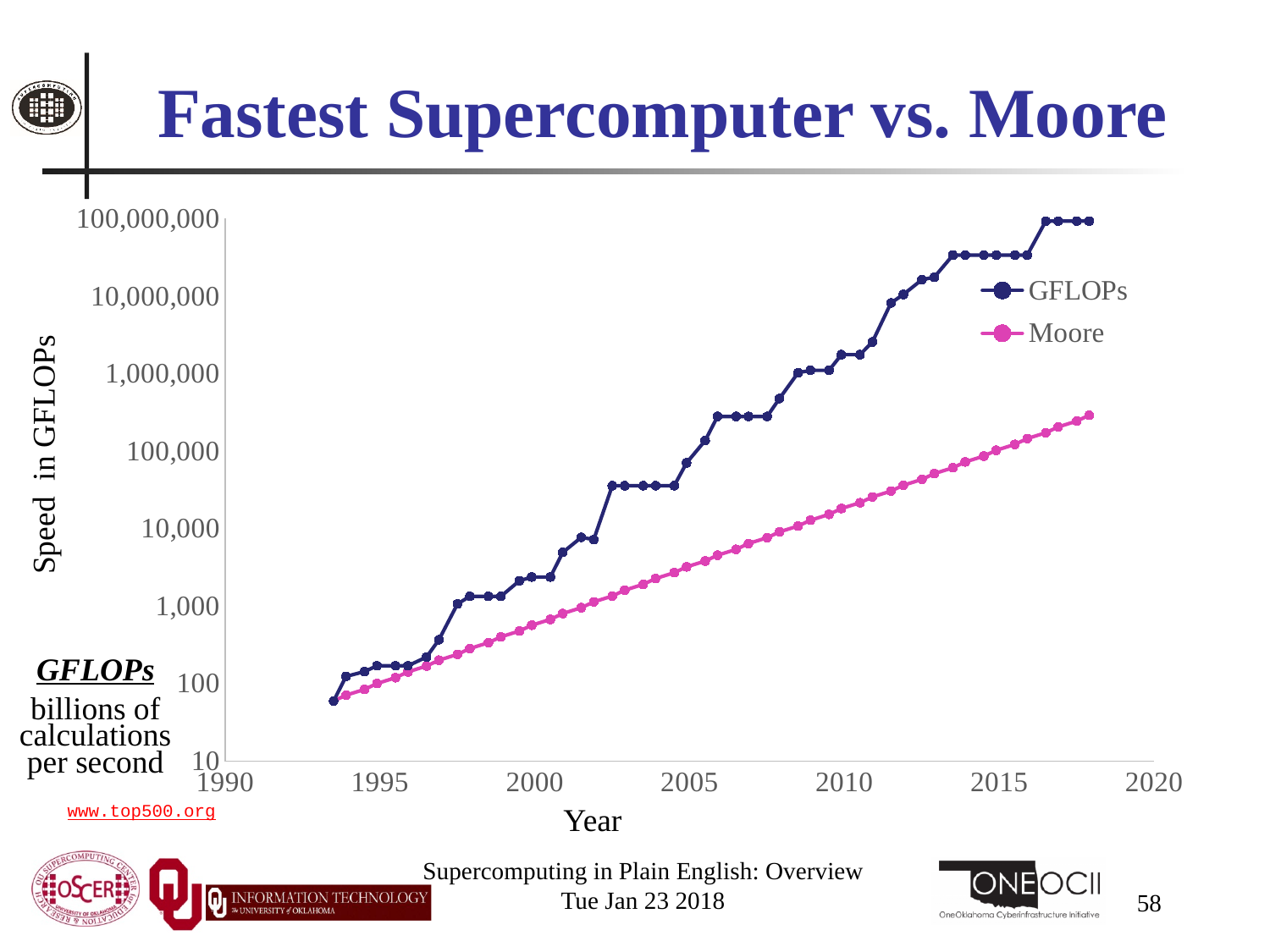
In 2010, which series has the higher value, GFLOPs or Moore? GFLOPs Is the GFLOPs value in 2018 greater or less than 10,000,000? greater What kind of chart is shown on the slide? line chart Is the GFLOPs value in 2005 greater or less than 10,000? greater Which series reaches the higher value by 2018, GFLOPs or Moore? GFLOPs What is the label of the x axis? Year What are the two series named in the legend? GFLOPs and Moore Is the Moore value in 2018 greater or less than 1,000,000? less How many series does the legend list? 2 Do the Moore values rise or fall as the year increases? rise Do the GFLOPs values rise or fall as the year increases? rise